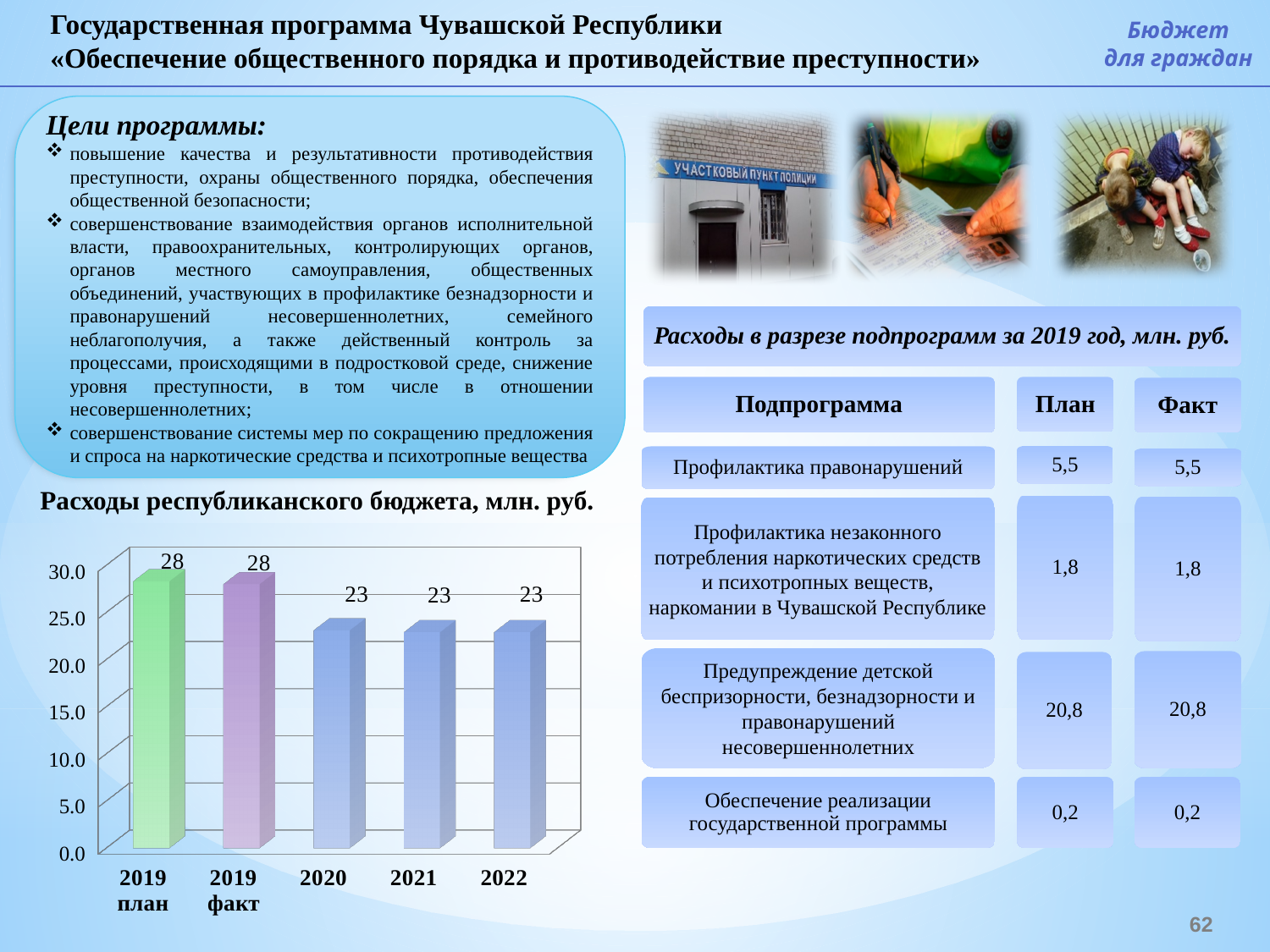
Do the values in the chart 'Расходы республиканского бюджета, млн. руб.' rise or fall from 2019 факт to 2020? fall What is the title of the bar chart on the slide? Расходы республиканского бюджета, млн. руб. What is the difference between the values for 2019 факт and 2020 in the chart 'Расходы республиканского бюджета, млн. руб.'? 5 Is the value for 2019 план in the chart 'Расходы республиканского бюджета, млн. руб.' greater or less than 25.0? greater Is the value for 2021 in the chart 'Расходы республиканского бюджета, млн. руб.' greater or less than 25.0? less What is the value for 2022 in the chart 'Расходы республиканского бюджета, млн. руб.'? 23 What is the value for 2019 план in the chart 'Расходы республиканского бюджета, млн. руб.'? 28 Which is larger in the chart 'Расходы республиканского бюджета, млн. руб.': the value for 2019 план or the value for 2020? 2019 план What kind of chart is 'Расходы республиканского бюджета, млн. руб.'? bar chart What is the value for 2021 in the chart 'Расходы республиканского бюджета, млн. руб.'? 23 How many categories are shown on the x axis of the chart 'Расходы республиканского бюджета, млн. руб.'? 5 What is the value for 2019 факт in the chart 'Расходы республиканского бюджета, млн. руб.'? 28